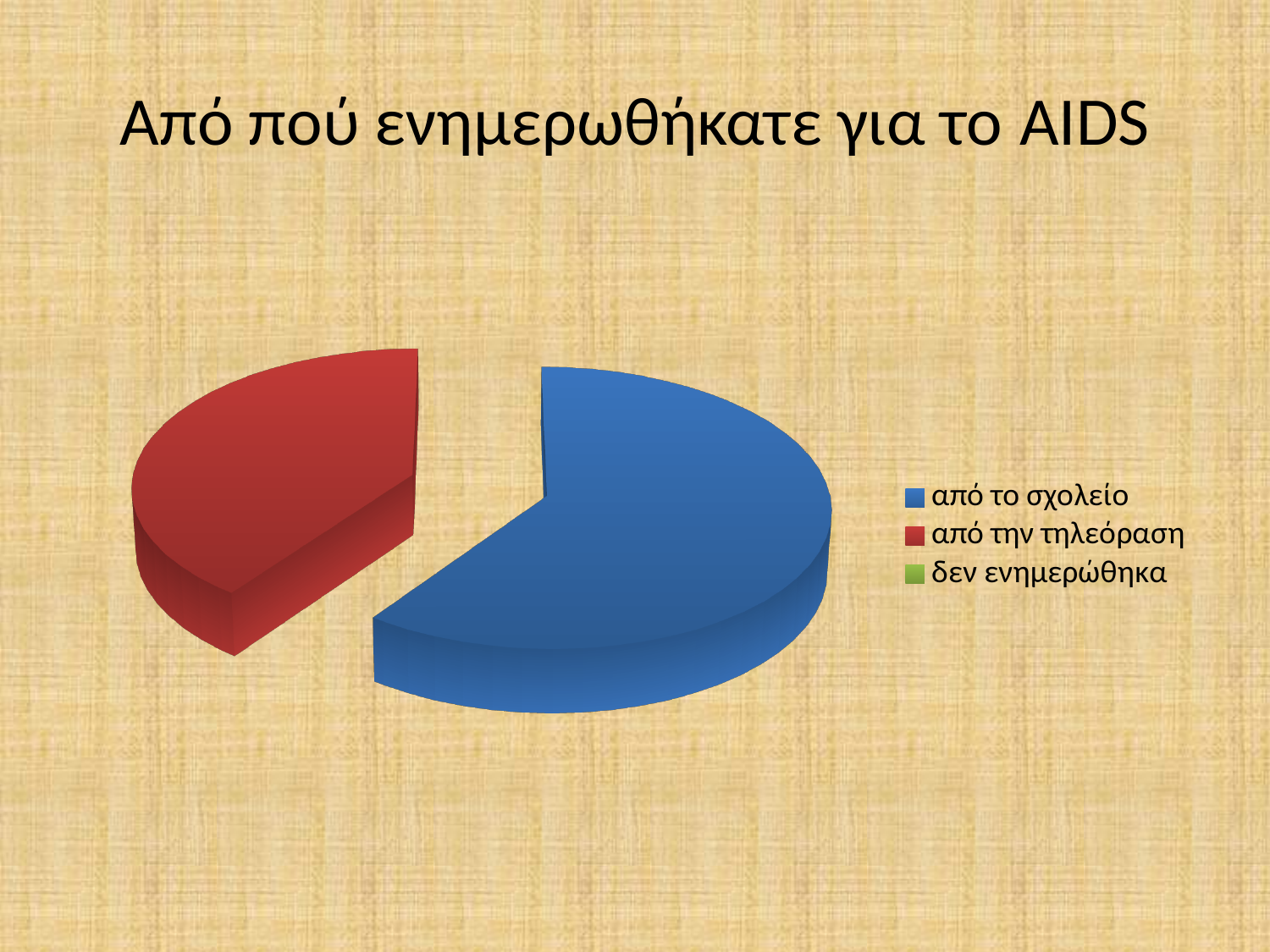
Which is larger, the slice for "από το σχολείο" or the slice for "από την τηλεόραση"? από το σχολείο Which category has the largest slice of the pie? από το σχολείο What kind of chart is shown on the slide? pie chart Which legend entry has no visible slice in the pie? δεν ενημερώθηκα What is the title of the slide? Από πού ενημερωθήκατε για το AIDS Which legend entry is shown in blue? από το σχολείο How many entries does the legend list? 3 Which of the two visible slices is smaller? από την τηλεόραση How many slices are visible in the pie? 2 What colour is the slice for "από την τηλεόραση"? red